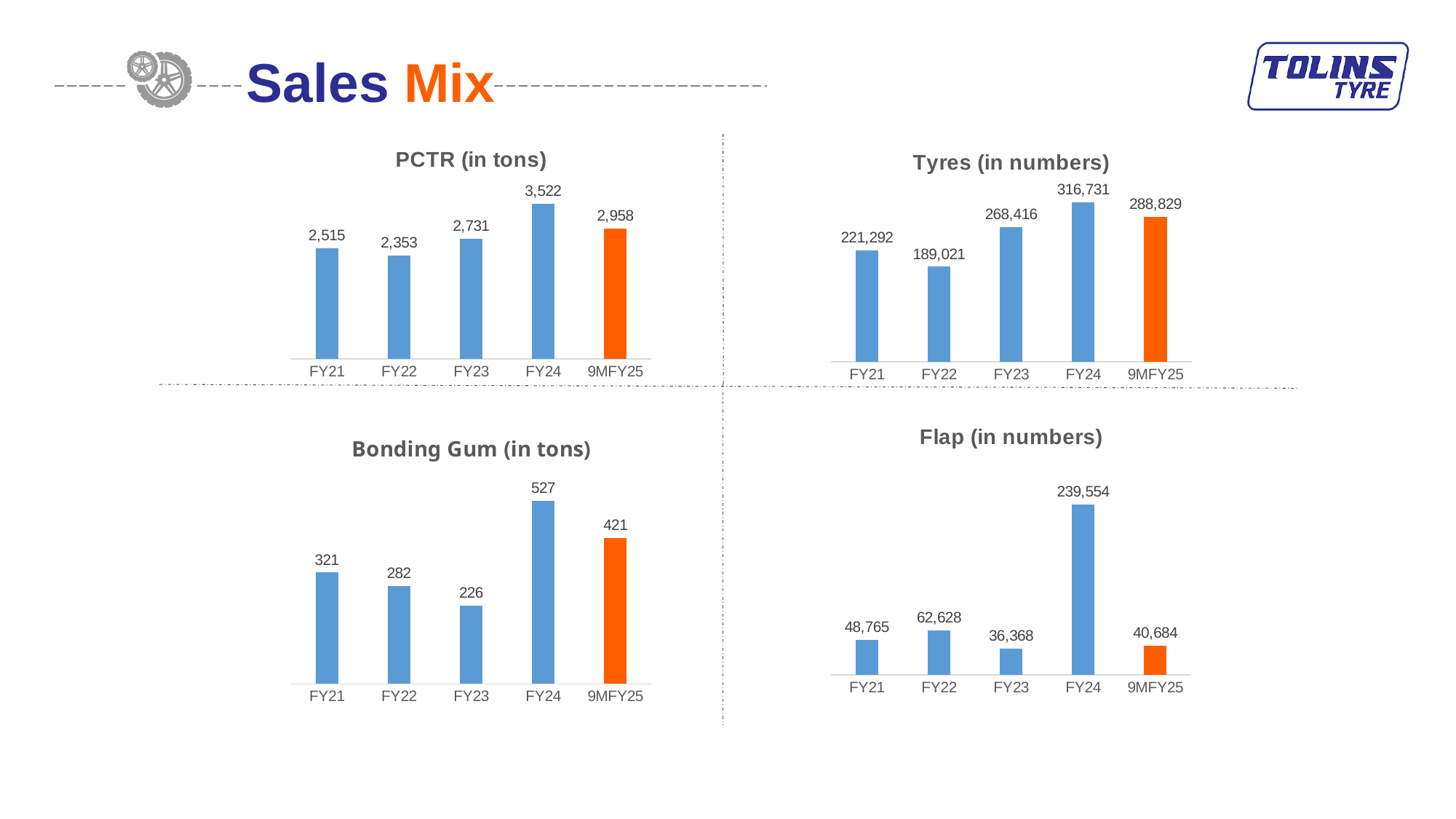
In the Tyres (in numbers) chart, what is the value for 9MFY25? 288,829 In the PCTR (in tons) chart, what is the value for FY24? 3,522 Which period's bar is coloured orange in each of the four charts? 9MFY25 In the Bonding Gum (in tons) chart, what is the difference between FY24 and 9MFY25? 106 In the Flap (in numbers) chart, which period has the highest value? FY24 In the Flap (in numbers) chart, what is the value for FY23? 36,368 What kind of chart is the Flap (in numbers) chart? Bar chart How many periods are shown on the x axis of the Bonding Gum (in tons) chart? 5 In the Tyres (in numbers) chart, do the values rise or fall from FY22 to FY24? Rise In the Bonding Gum (in tons) chart, which period has the lowest value? FY23 In the PCTR (in tons) chart, what is the difference between FY24 and FY23? 791 In the Tyres (in numbers) chart, which is larger, FY21 or FY22? FY21